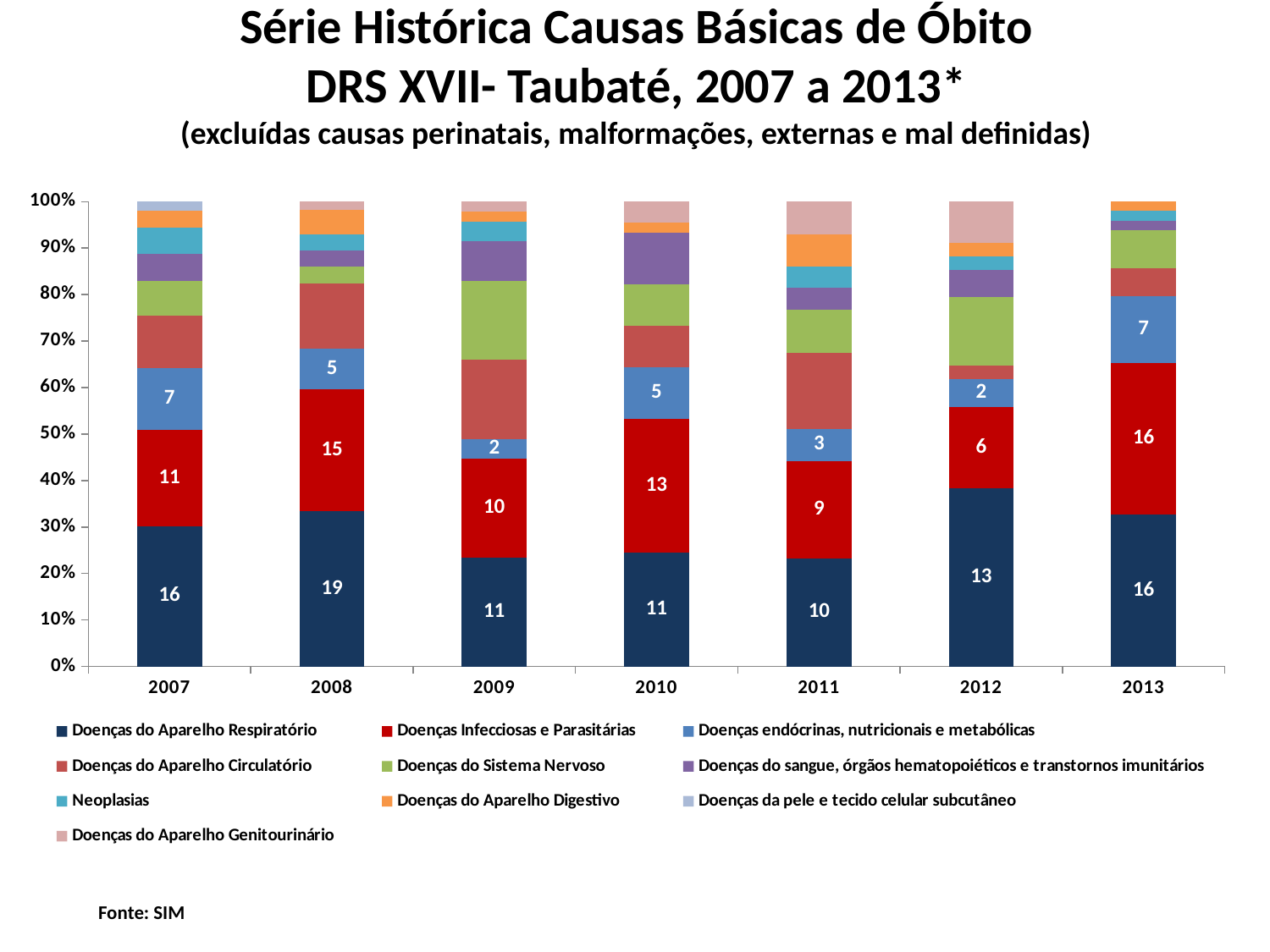
In which year does Doenças do Aparelho Respiratório have its highest labelled value? 2008 What is the data label for Doenças endócrinas, nutricionais e metabólicas in 2011? 3 How many years are shown on the x axis? 7 What kind of chart is shown on the slide? stacked bar chart In which year does Doenças Infecciosas e Parasitárias have its lowest labelled value? 2012 What is the difference between the Doenças Infecciosas e Parasitárias labels for 2013 and 2012? 10 What is the data label for Doenças do Aparelho Respiratório in 2008? 19 What is the data label for Doenças Infecciosas e Parasitárias in 2010? 13 In 2012, does the top of the Doenças do Aparelho Respiratório segment lie above or below 30%? above Which is larger in 2009: the label for Doenças do Aparelho Respiratório or for Doenças Infecciosas e Parasitárias? Doenças do Aparelho Respiratório How many series does the legend list? 10 Which colour represents Doenças Infecciosas e Parasitárias in the chart? red